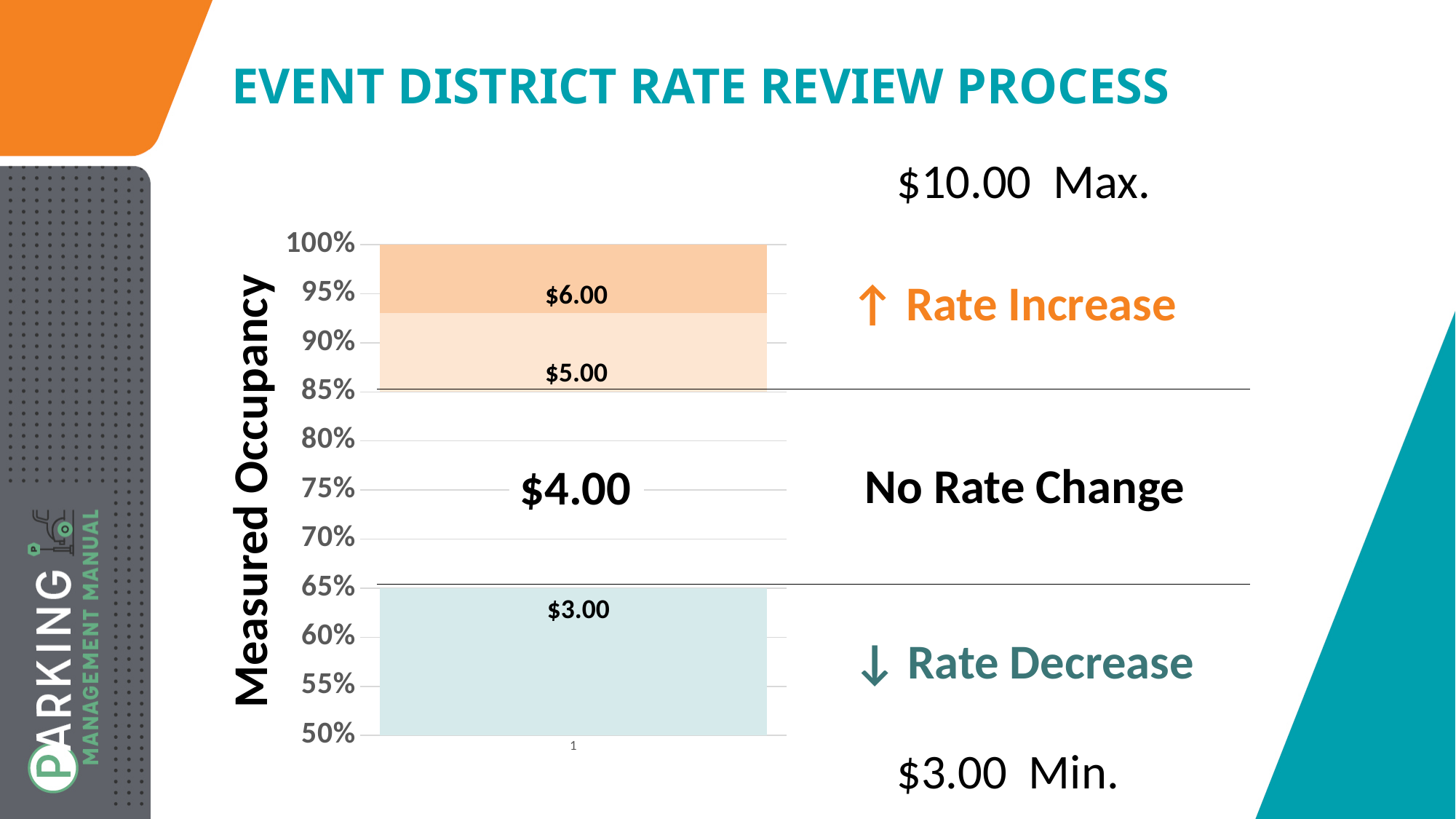
What is the difference between the $6.00 rate and the $5.00 rate shown on the bar? $1.00 What rate is shown for the 'No Rate Change' band between 65% and 85% occupancy? $4.00 What rate is printed on the topmost segment of the bar, just below 100% occupancy? $6.00 How many rate-labelled segments are shown on the bar? 3 What rate is printed on the bar segment just above the 85% occupancy line? $5.00 What is the maximum rate stated on the slide? $10.00 What kind of chart is shown on the slide? bar chart What rate is printed on the bar segment spanning 50% to 65% occupancy? $3.00 What is the label of the vertical axis of the chart? Measured Occupancy Which is larger, the rate on the top segment of the bar or the rate on the bottom segment? the top segment ($6.00) Above what measured occupancy does the chart indicate a rate increase? 85% What is the minimum rate stated on the slide? $3.00